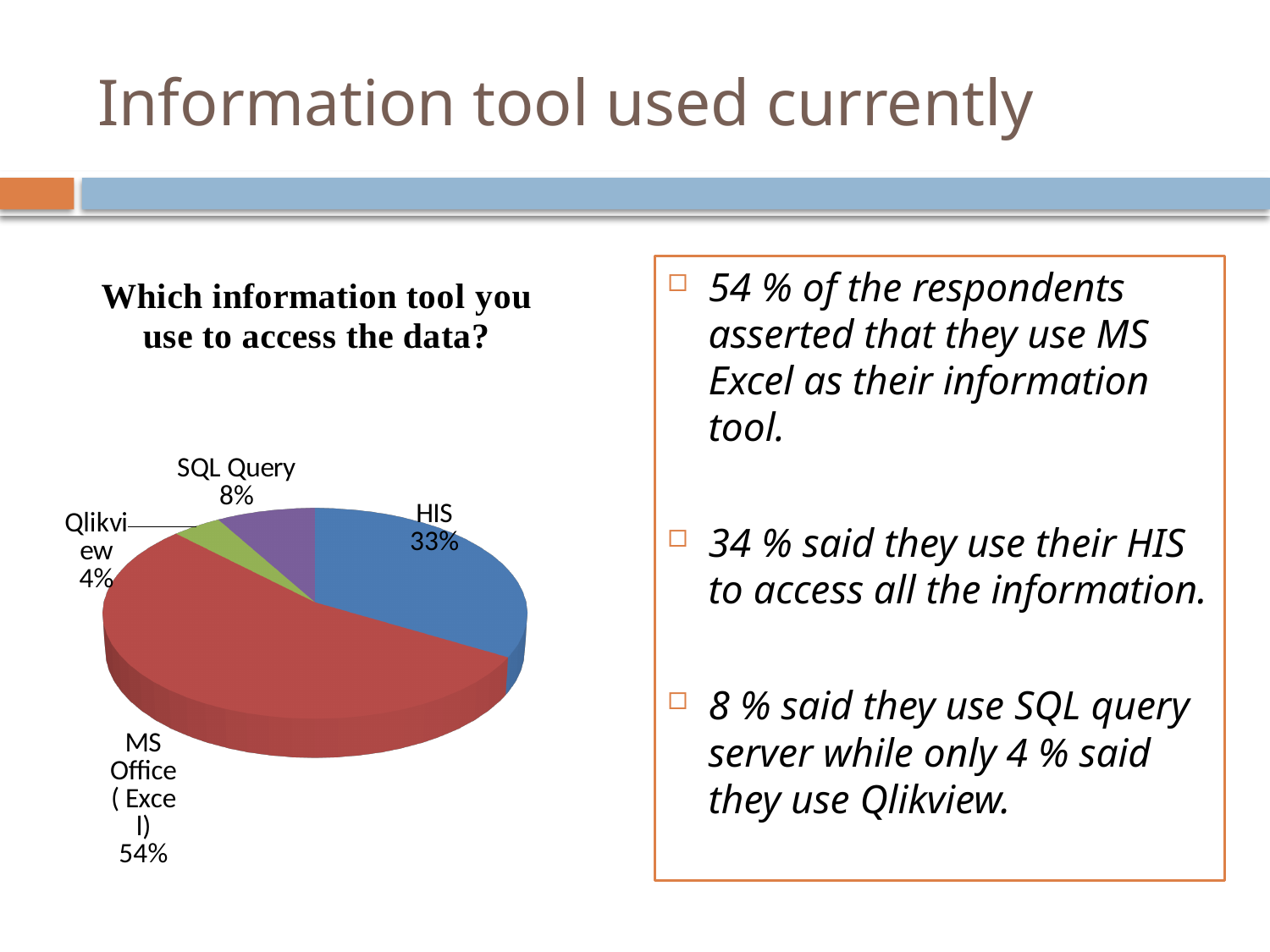
Which information tool has the smallest share in the pie chart? Qlikview What percentage of respondents use HIS according to the chart? 33% How many slices does the pie chart have? 4 What colour is the HIS slice in the pie chart? Blue What percentage of respondents use Qlikview according to the chart? 4% What is the title of the chart? Which information tool you use to access the data? Which slice is larger, SQL Query or Qlikview? SQL Query What is the difference in percentage points between the MS Office (Excel) slice and the HIS slice? 21 What type of chart is shown on the slide? Pie chart Which information tool has the largest share in the pie chart? MS Office (Excel) What percentage of respondents use MS Office (Excel) according to the chart? 54% What percentage of respondents use SQL Query according to the chart? 8%